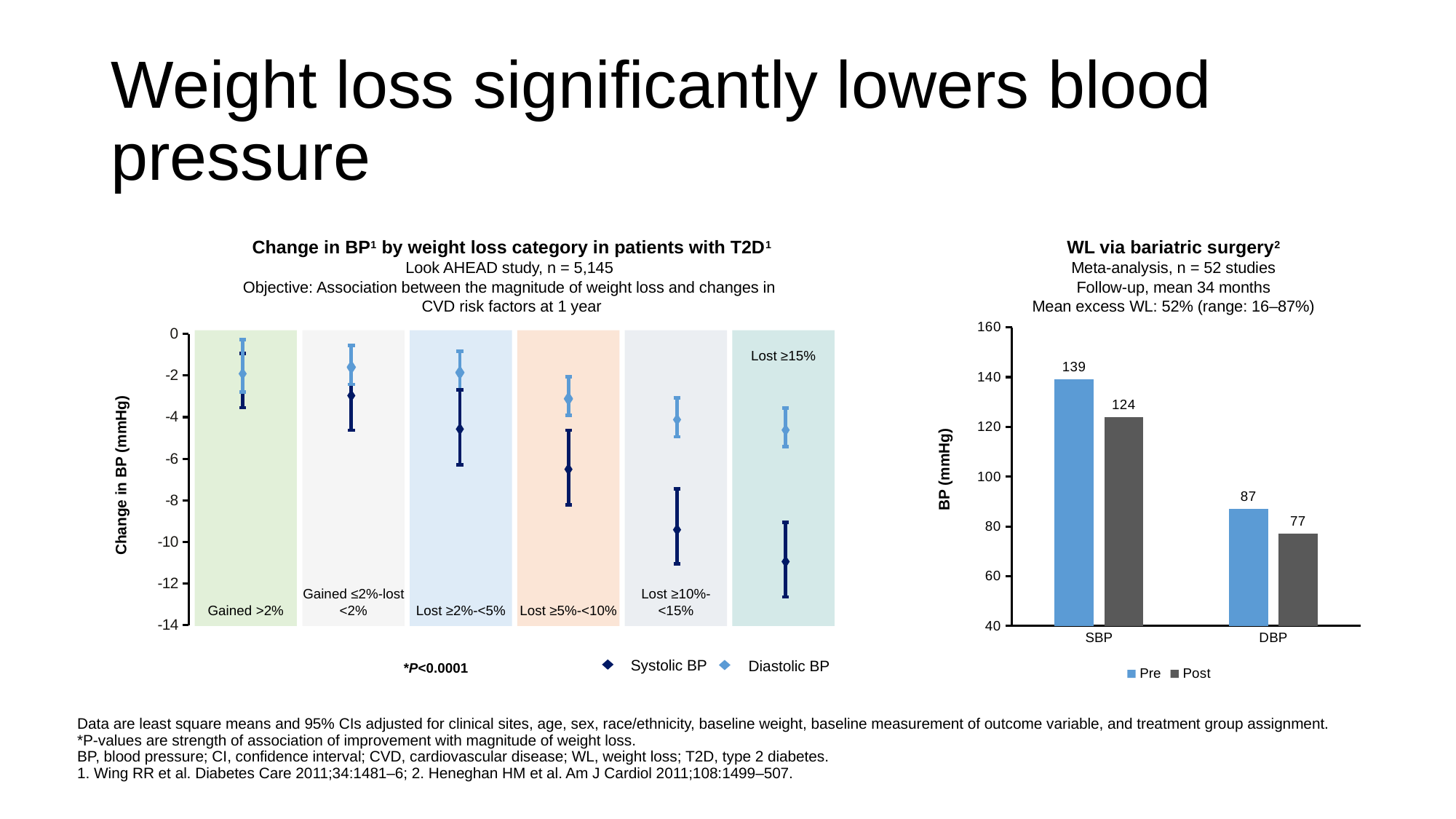
In the 'Change in BP by weight loss category' chart, which two series does the legend list? Systolic BP and Diastolic BP In the 'WL via bariatric surgery' chart, how many series does the legend list? 2 In the 'Change in BP by weight loss category' chart, which weight loss category shows the largest reduction in Systolic BP? Lost ≥15% In the 'Change in BP by weight loss category' chart, is the Systolic BP value for 'Lost ≥15%' greater or less than -10? less What kind of chart is the 'WL via bariatric surgery' chart? Bar chart In the 'WL via bariatric surgery' chart, by how much does SBP fall from Pre to Post? 15 In the 'WL via bariatric surgery' chart, what is the Post value for DBP? 77 In the 'WL via bariatric surgery' chart, by how much does DBP fall from Pre to Post? 10 In the 'WL via bariatric surgery' chart, what is the Pre value for SBP? 139 In the 'Change in BP by weight loss category' chart, does the change in Systolic BP become more negative or less negative as weight loss increases across the categories? More negative In the 'WL via bariatric surgery' chart, which bar has the lowest value? DBP Post (77) In the 'Change in BP by weight loss category' chart, how many weight loss categories are shown on the x axis? 6